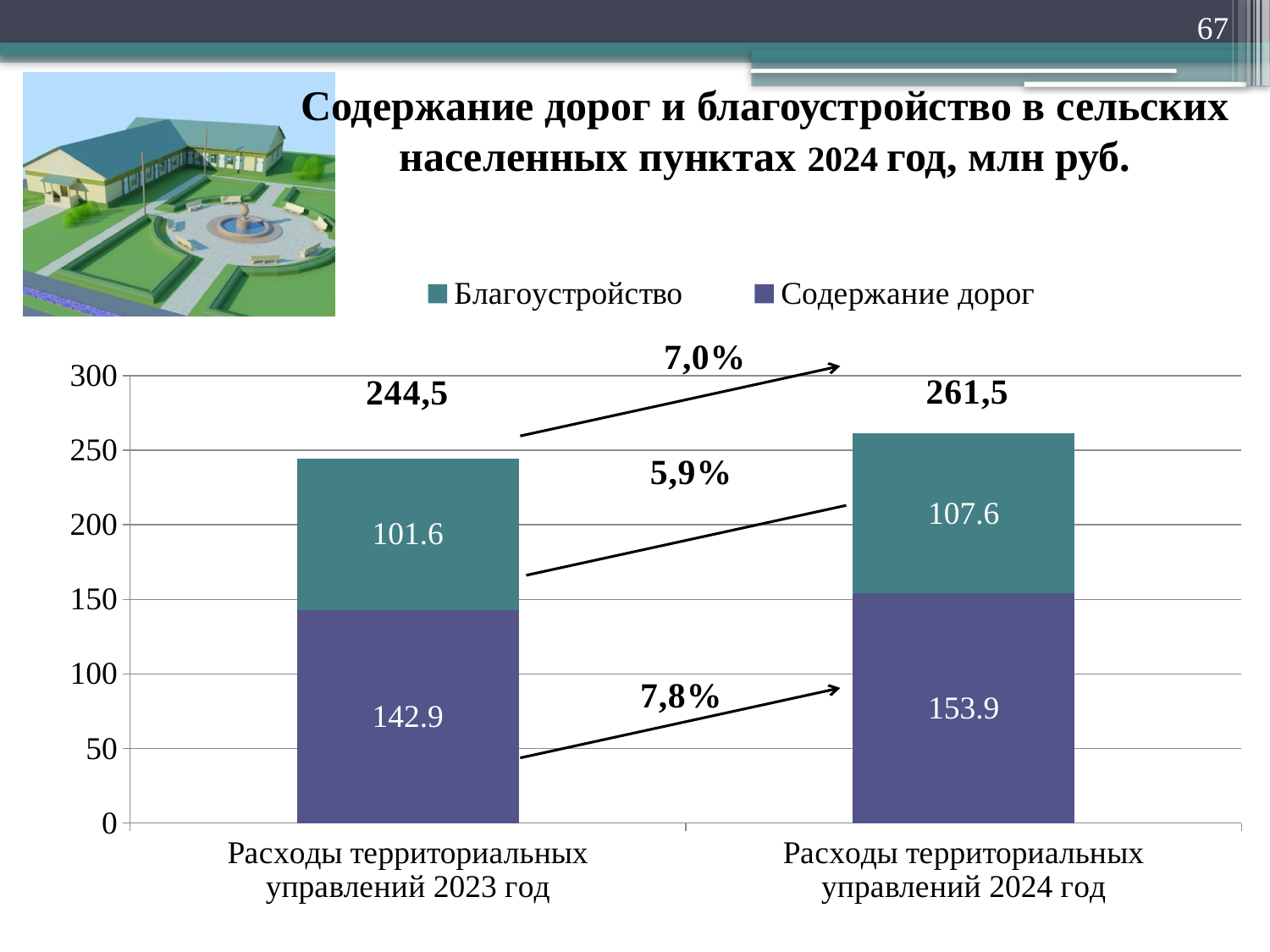
What is the value for Благоустройство in Расходы территориальных управлений 2023 год? 101.6 What kind of chart is shown on the slide? Stacked bar chart What percentage growth is shown for Содержание дорог between 2023 and 2024? 7,8% What is the value for Благоустройство in Расходы территориальных управлений 2024 год? 107.6 What is the total of the stacked bar for Расходы территориальных управлений 2024 год? 261,5 Which is larger: Благоустройство in 2023 or Благоустройство in 2024? Благоустройство in 2024 Which category has the highest total? Расходы территориальных управлений 2024 год How many series does the legend list? 2 What is the value for Содержание дорог in Расходы территориальных управлений 2023 год? 142.9 How many categories are shown on the x axis? 2 What is the difference between the Содержание дорог values for 2024 and 2023? 11.0 What is the total of the stacked bar for Расходы территориальных управлений 2023 год? 244,5